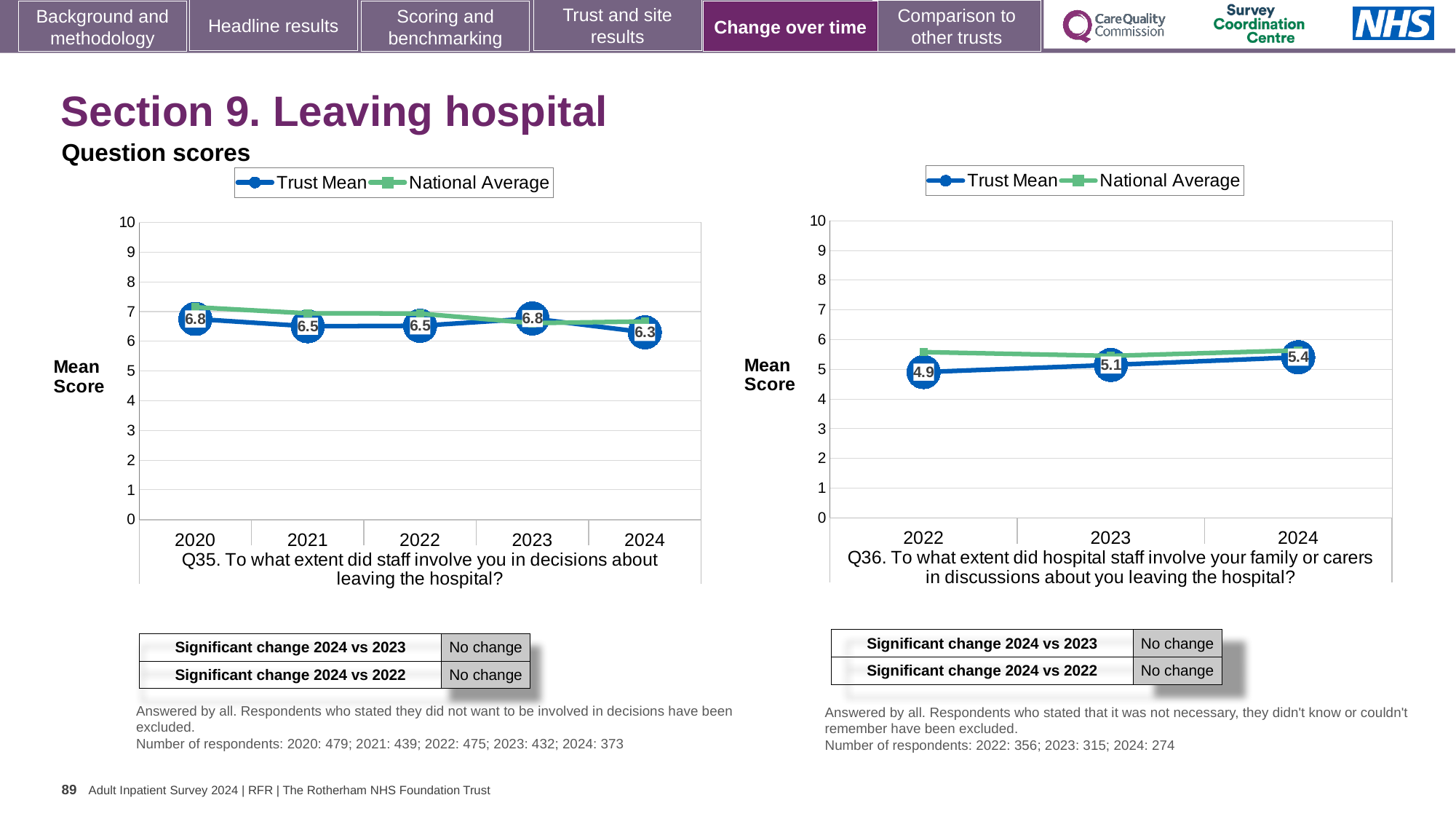
On the Q35 chart (left), how many years are plotted on the x axis? 5 On the Q35 chart (left), is the National Average for 2020 greater or less than 7? greater What kind of chart is the Q36 chart (right)? line chart On the Q36 chart (right), what is the difference between the Trust Mean scores for 2024 and 2022? 0.5 On the Q35 chart (left), what is the Trust Mean score for 2020? 6.8 On the Q35 chart (left), what is the difference between the Trust Mean scores for 2023 and 2024? 0.5 On the Q36 chart (right), how many series does the legend list? 2 On the Q35 chart (left), which year has the lowest Trust Mean score? 2024 On the Q36 chart (right), what is the Trust Mean score for 2022? 4.9 On the Q36 chart (right), which year has the highest Trust Mean score? 2024 On the Q35 chart (left), what is the Trust Mean score for 2024? 6.3 On the Q36 chart (right), does the Trust Mean rise or fall from 2022 to 2024? rise